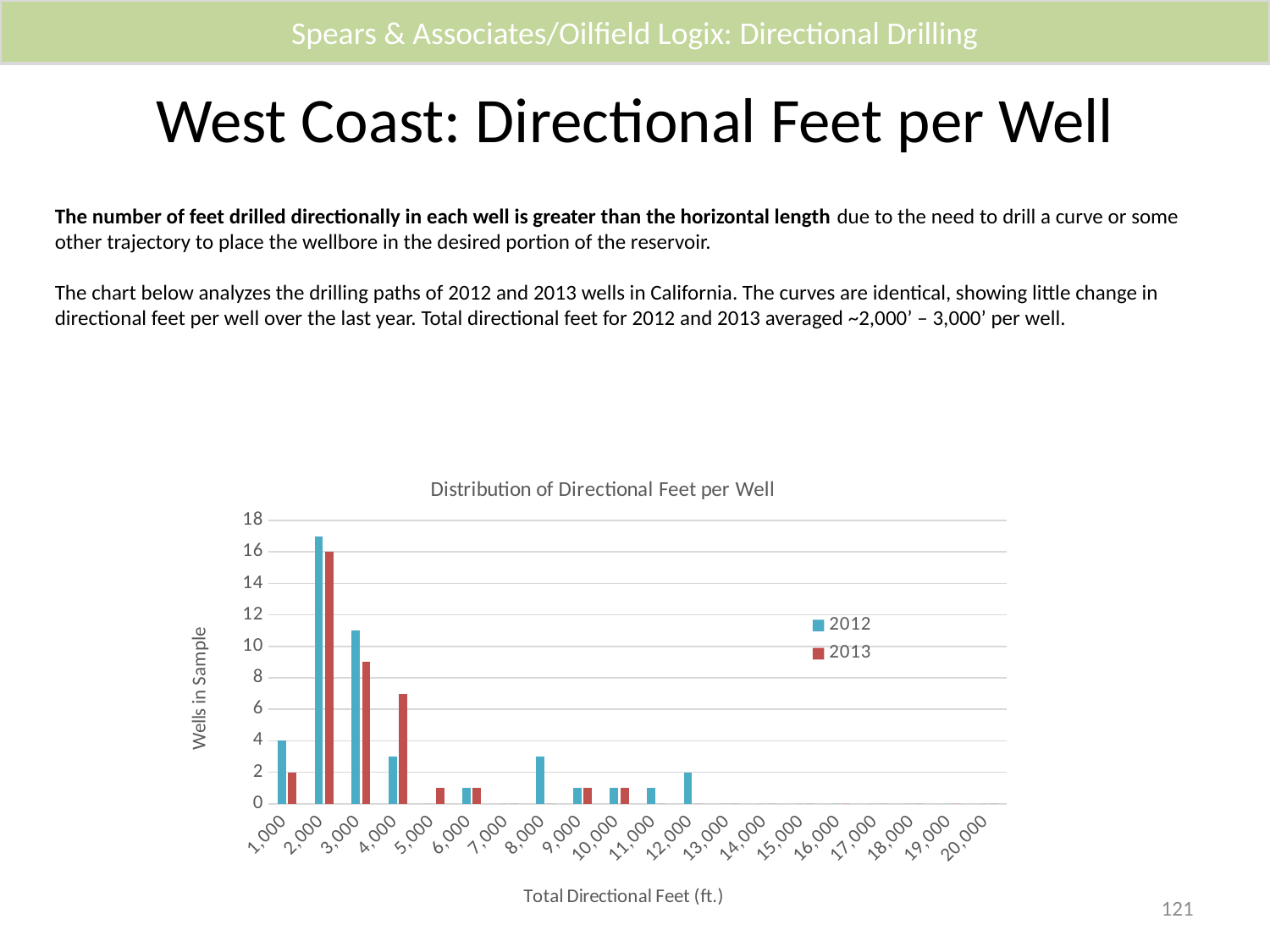
Which x-axis category has the highest 2012 value? 2,000 What is the 2012 value at 12,000 total directional feet? 2 At 4,000 total directional feet, which series has the larger value, 2012 or 2013? 2013 Is the 2013 value at 4,000 total directional feet greater or less than 8? less How many categories are shown along the x axis of the chart? 20 How many series does the legend of the chart list? 2 Which x-axis category has the highest 2013 value? 2,000 Is the 2012 value at 3,000 total directional feet greater or less than 10? greater What is the 2013 value at 2,000 total directional feet? 16 What kind of chart is shown on the slide? bar chart What is the 2012 value at 1,000 total directional feet? 4 What is the title of the chart's y axis? Wells in Sample